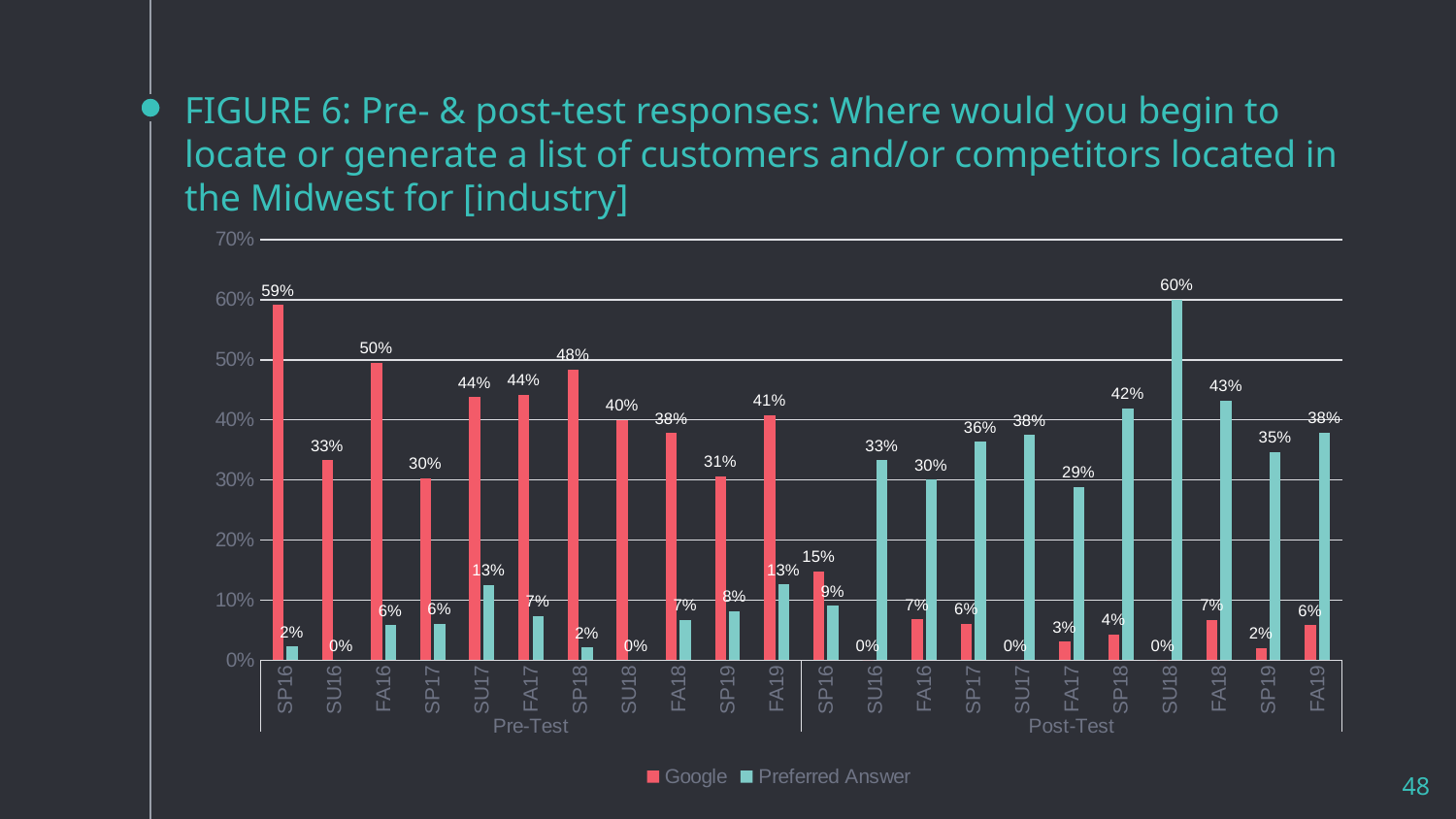
How many series does the legend list? 2 In the Post-Test group, which is larger for FA18: the Google value or the Preferred Answer value? Preferred Answer Which Pre-Test term has the highest Google value? SP16 What is the Preferred Answer value for SU18 in the Post-Test group? 60% Which colour represents the Preferred Answer series? Teal What kind of chart is shown on the slide? Bar chart How many terms are shown in the Pre-Test group? 11 Which Post-Test term has the highest Preferred Answer value? SU18 What is the difference between the Google value and the Preferred Answer value for SP16 in the Pre-Test group? 57% What is the Google value for SP16 in the Pre-Test group? 59% What is the Google value for FA17 in the Post-Test group? 3% Which Post-Test term has the lowest Preferred Answer value? SP16